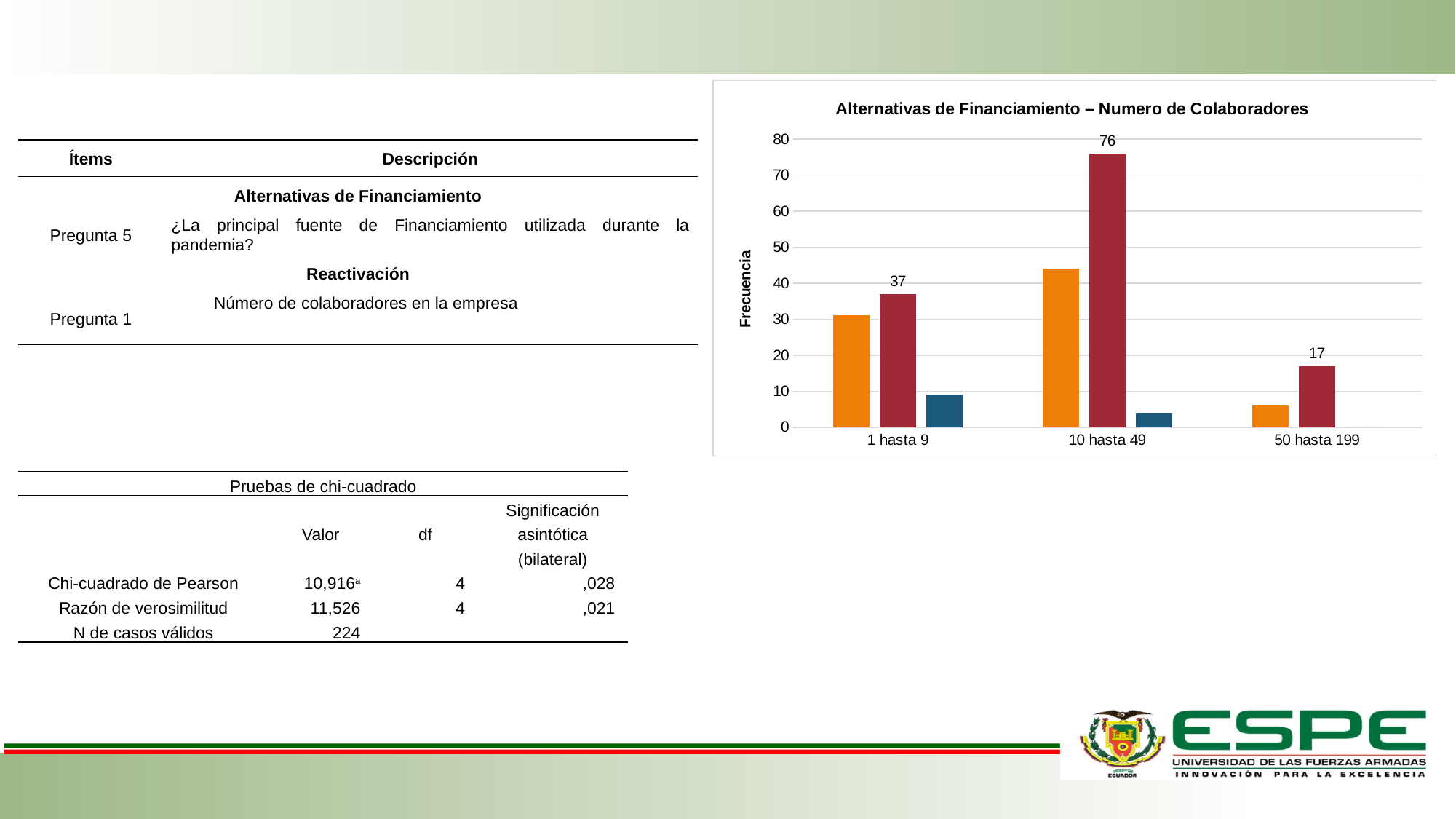
Is the value of the orange bar for '50 hasta 199' greater or less than 10? less What is the value of the red bar for the '50 hasta 199' category? 17 What is the difference between the red bar values for '10 hasta 49' and '1 hasta 9'? 39 Among the red bars, which category has the highest value? 10 hasta 49 What kind of chart is shown on the slide? Bar chart Which is larger: the red bar for '1 hasta 9' or the red bar for '50 hasta 199'? 1 hasta 9 What is the value of the red bar for the '1 hasta 9' category? 37 What is the title of the chart's vertical axis? Frecuencia Is the value of the orange bar for '10 hasta 49' greater or less than 40? greater How many categories are shown on the x axis of the chart? 3 Among the red bars, which category has the lowest value? 50 hasta 199 What is the value of the red bar for the '10 hasta 49' category? 76